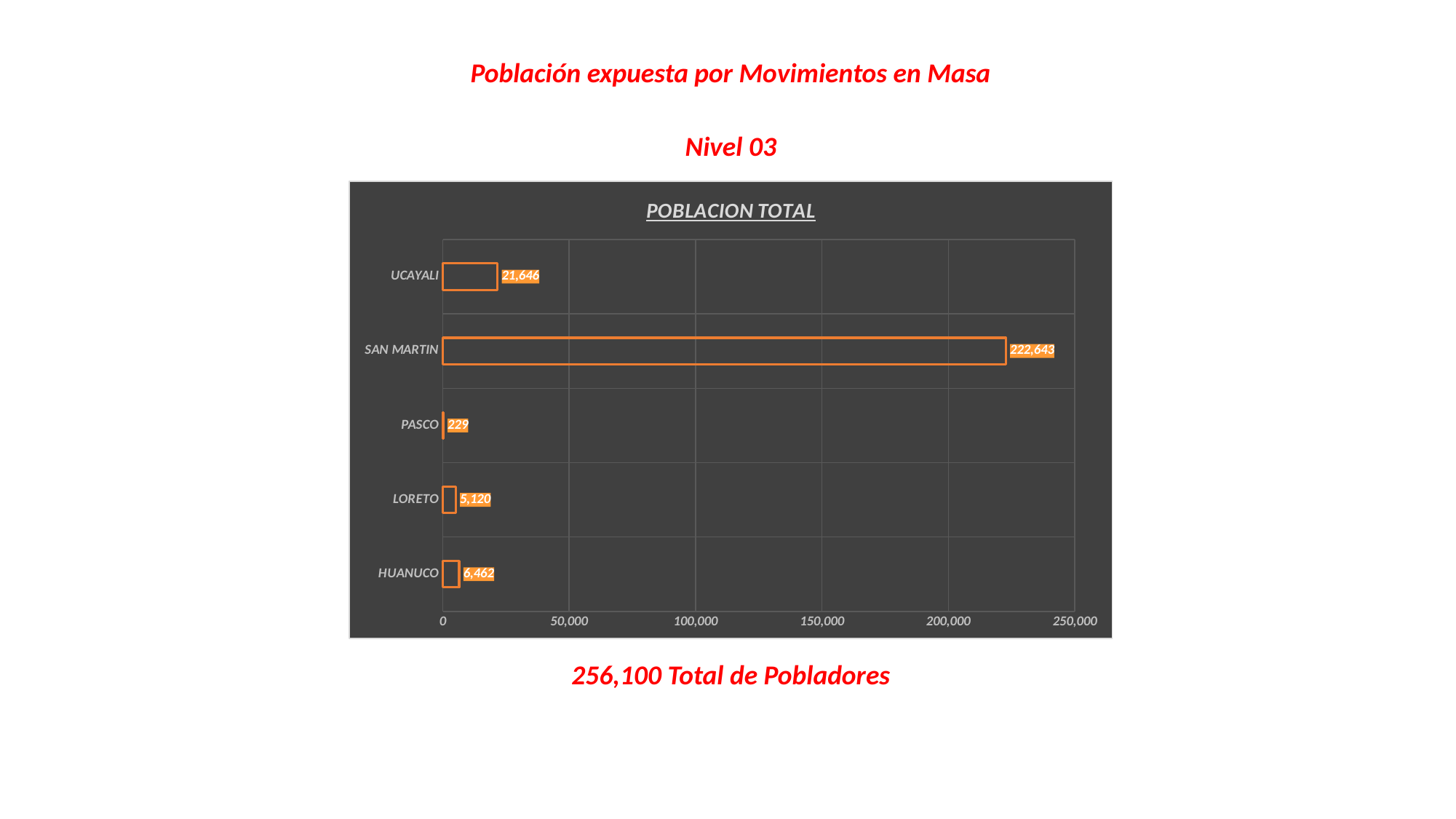
What is the value for HUANUCO? 6,462 Is the value for SAN MARTIN greater or less than 200,000? greater What kind of chart is shown on the slide? bar chart What is the difference between the values for SAN MARTIN and UCAYALI? 201,997 How many categories are shown in the chart? 5 What is the value for SAN MARTIN? 222,643 What is the value for LORETO? 5,120 Which is larger, the value for HUANUCO or the value for LORETO? HUANUCO Which category has the lowest value? PASCO What is the value for PASCO? 229 Which category has the highest value? SAN MARTIN What is the value for UCAYALI? 21,646